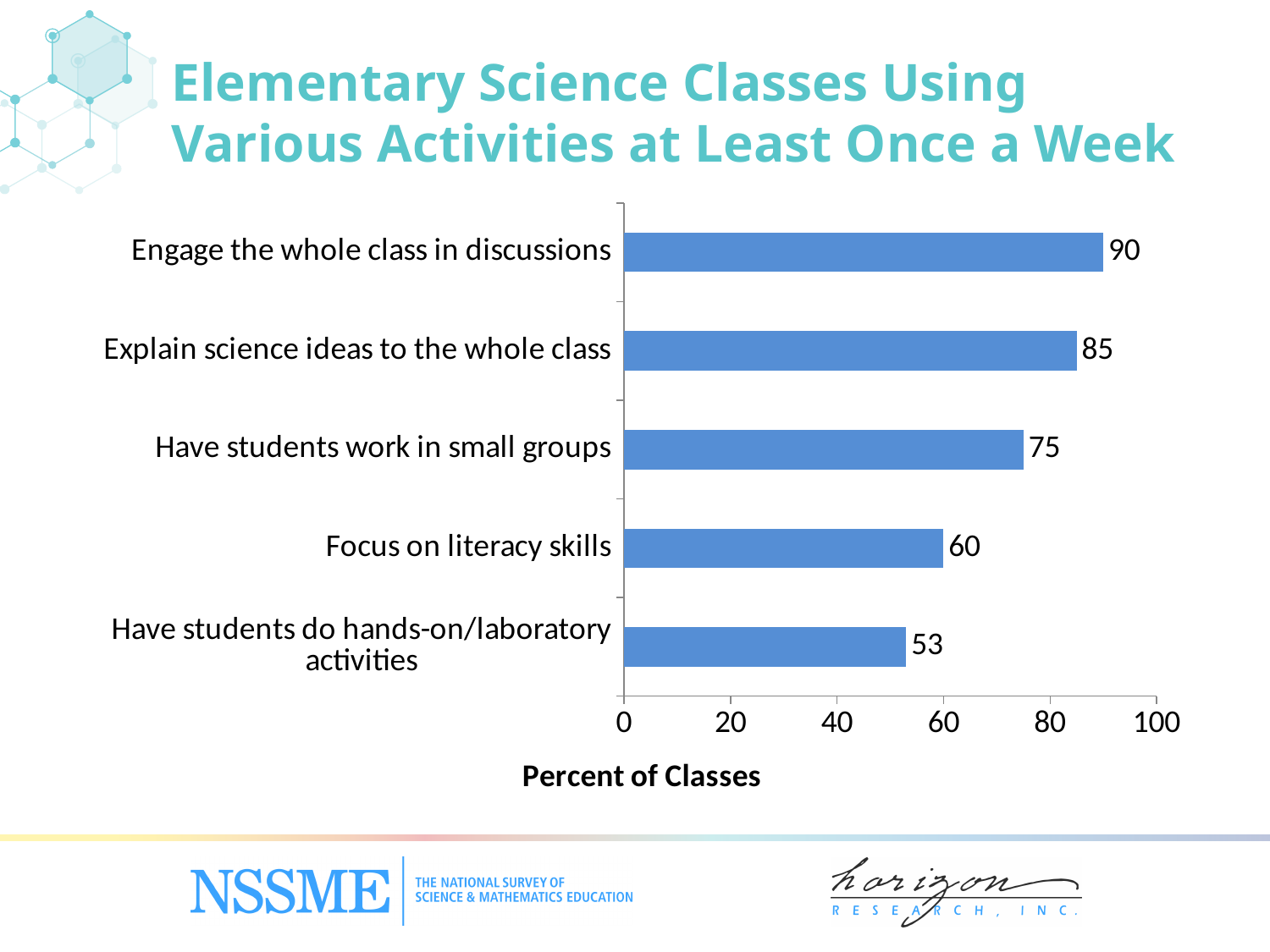
What is the difference between 'Explain science ideas to the whole class' and 'Have students work in small groups'? 10 What percent of classes engage the whole class in discussions at least once a week? 90 Which is larger: 'Focus on literacy skills' or 'Have students work in small groups'? Have students work in small groups How many activities are shown on the chart? 5 What is the difference between the highest and lowest values on the chart? 37 What percent of classes have students do hands-on/laboratory activities at least once a week? 53 Is the value for 'Explain science ideas to the whole class' greater or less than 80? greater Which activity has the highest percent of classes? Engage the whole class in discussions What kind of chart is shown on the slide? Bar chart What is the label of the horizontal axis? Percent of Classes Which activity has the lowest percent of classes? Have students do hands-on/laboratory activities What is the value for 'Focus on literacy skills'? 60